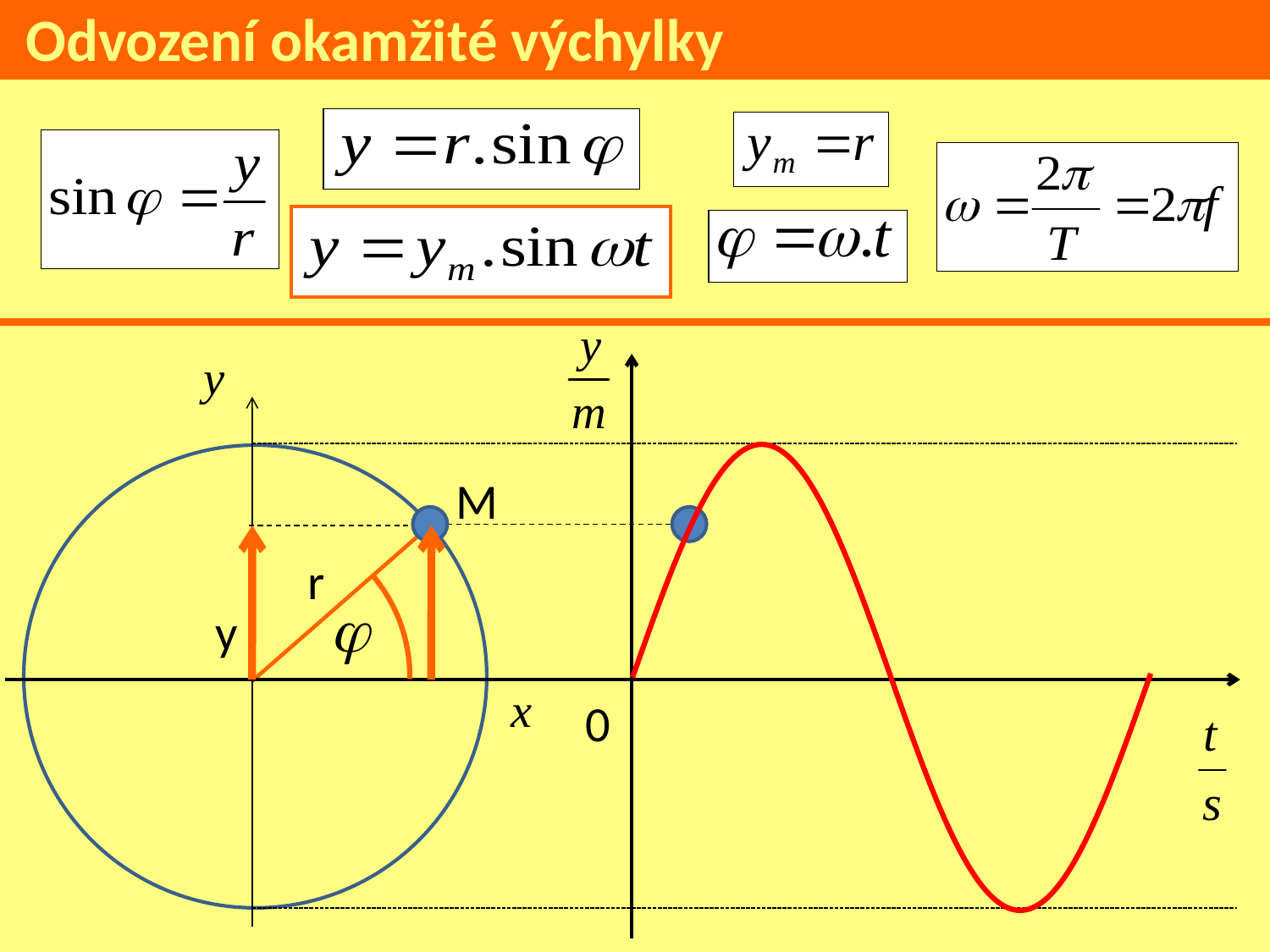
In the right-hand graph, does the red curve rise or fall immediately after the origin 0? rise What is the label on the vertical axis of the right-hand graph? y/m What is the label on the horizontal axis of the right-hand graph? t/s What kind of chart is the right-hand graph with the red curve? line chart